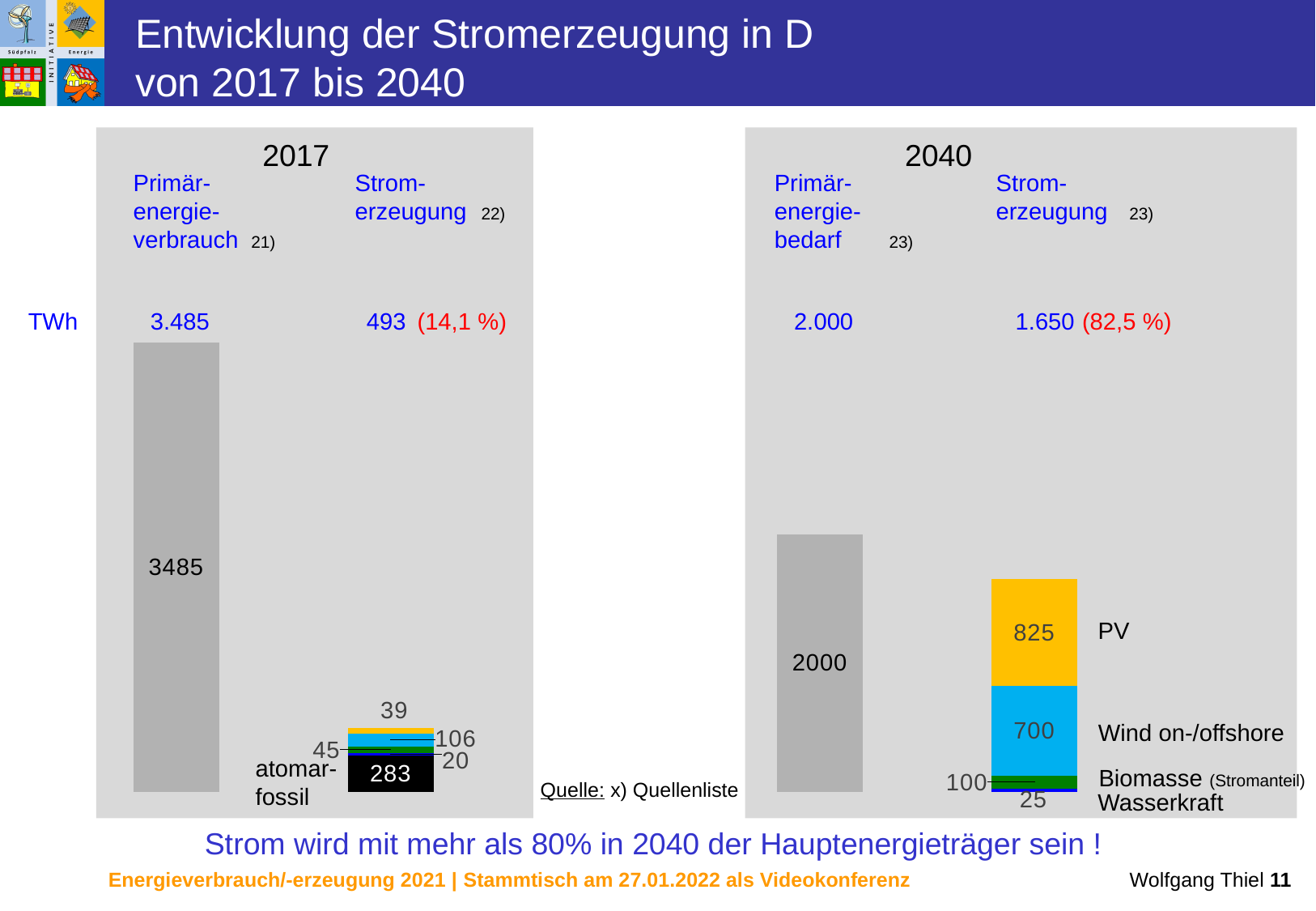
In the 2017 chart, what is the value of the Primärenergieverbrauch bar? 3485 In the 2040 chart, which electricity source has the smallest value? Wasserkraft In the 2040 chart, which electricity source has the largest value? PV In the 2040 chart, what is the value for Wasserkraft? 25 Which is larger: the Primärenergie bar in the 2017 chart or in the 2040 chart? 2017 In the 2040 chart, what is the value for Wind on-/offshore? 700 In the 2040 chart, what is the value for PV? 825 In the 2040 chart, what is the difference between PV and Wind on-/offshore? 125 In the 2040 chart, what is the total of the stacked Stromerzeugung bar? 1.650 In the 2017 chart, what is the value of the atomar-fossil segment? 283 In the 2040 chart, what is the value for Biomasse? 100 In the 2040 chart, how many segments make up the stacked Stromerzeugung bar? 4